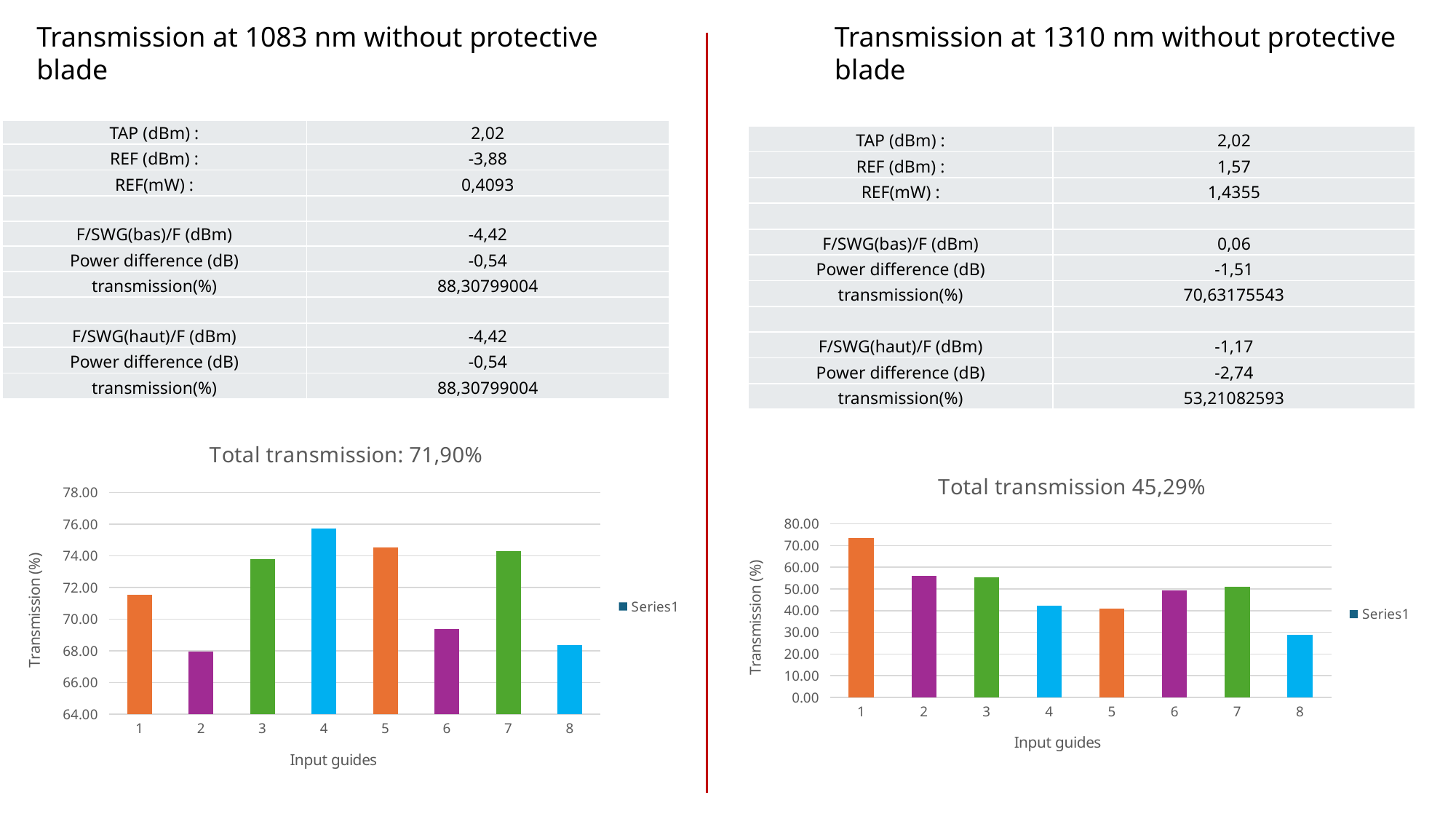
What kind of chart is the chart titled 'Total transmission: 71,90%'? Bar chart On the chart titled 'Total transmission: 71,90%', which input guide has the highest transmission? 4 On the chart titled 'Total transmission: 71,90%', which has the larger value, input guide 3 or input guide 6? 3 On the chart titled 'Total transmission 45,29%', which input guide has the highest transmission? 1 On the chart titled 'Total transmission: 71,90%', is the value for input guide 2 greater or less than 70.00? less On the chart titled 'Total transmission: 71,90%', is the value for input guide 4 greater or less than 74.00? greater How many input guides are plotted on the chart titled 'Total transmission: 71,90%'? 8 On the chart titled 'Total transmission 45,29%', which input guide has the lowest transmission? 8 How many series does the legend list on the chart titled 'Total transmission 45,29%'? 1 On the chart titled 'Total transmission 45,29%', which has the larger value, input guide 2 or input guide 4? 2 On the chart titled 'Total transmission 45,29%', is the value for input guide 1 greater or less than 70.00? greater